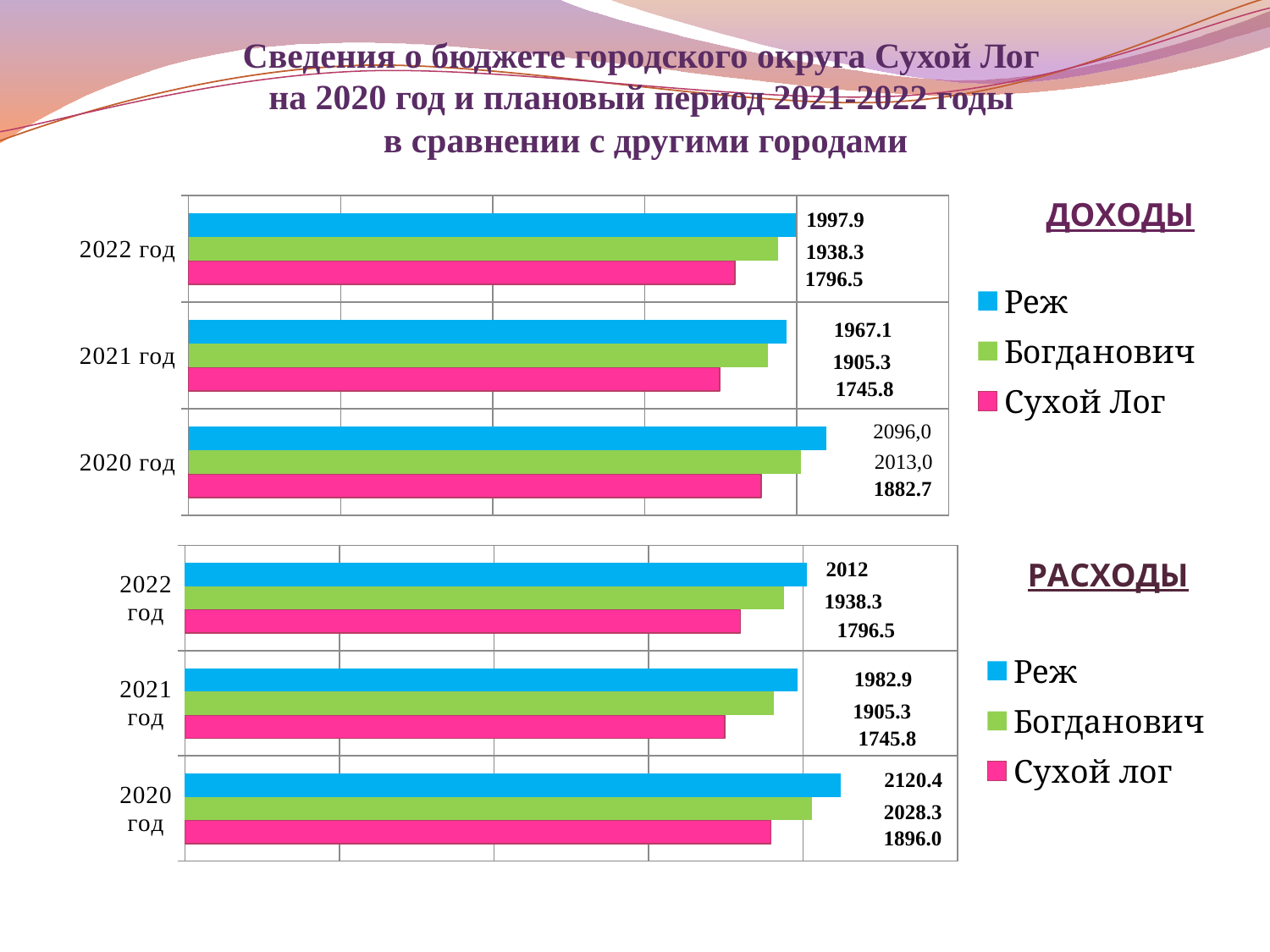
In the РАСХОДЫ chart, what is the value for Реж in 2020 год? 2120.4 In the РАСХОДЫ chart, which city has the lowest value in 2022 год? Сухой лог In the ДОХОДЫ chart, what is the value for Сухой Лог in 2020 год? 1882.7 In the РАСХОДЫ chart, what is the difference between Реж and Богданович in 2020 год? 92.1 In the ДОХОДЫ chart, what is the value for Богданович in 2021 год? 1905.3 In the РАСХОДЫ chart, what is the value for Сухой лог in 2021 год? 1745.8 In the ДОХОДЫ chart, which city has the highest value in 2020 год? Реж How many year categories are shown in the ДОХОДЫ chart? 3 How many series does the legend of the РАСХОДЫ chart list? 3 In the ДОХОДЫ chart, which is larger in 2021 год: Реж or Сухой Лог? Реж What kind of chart is the ДОХОДЫ chart? Bar chart In the ДОХОДЫ chart, what is the value for Реж in 2022 год? 1997.9